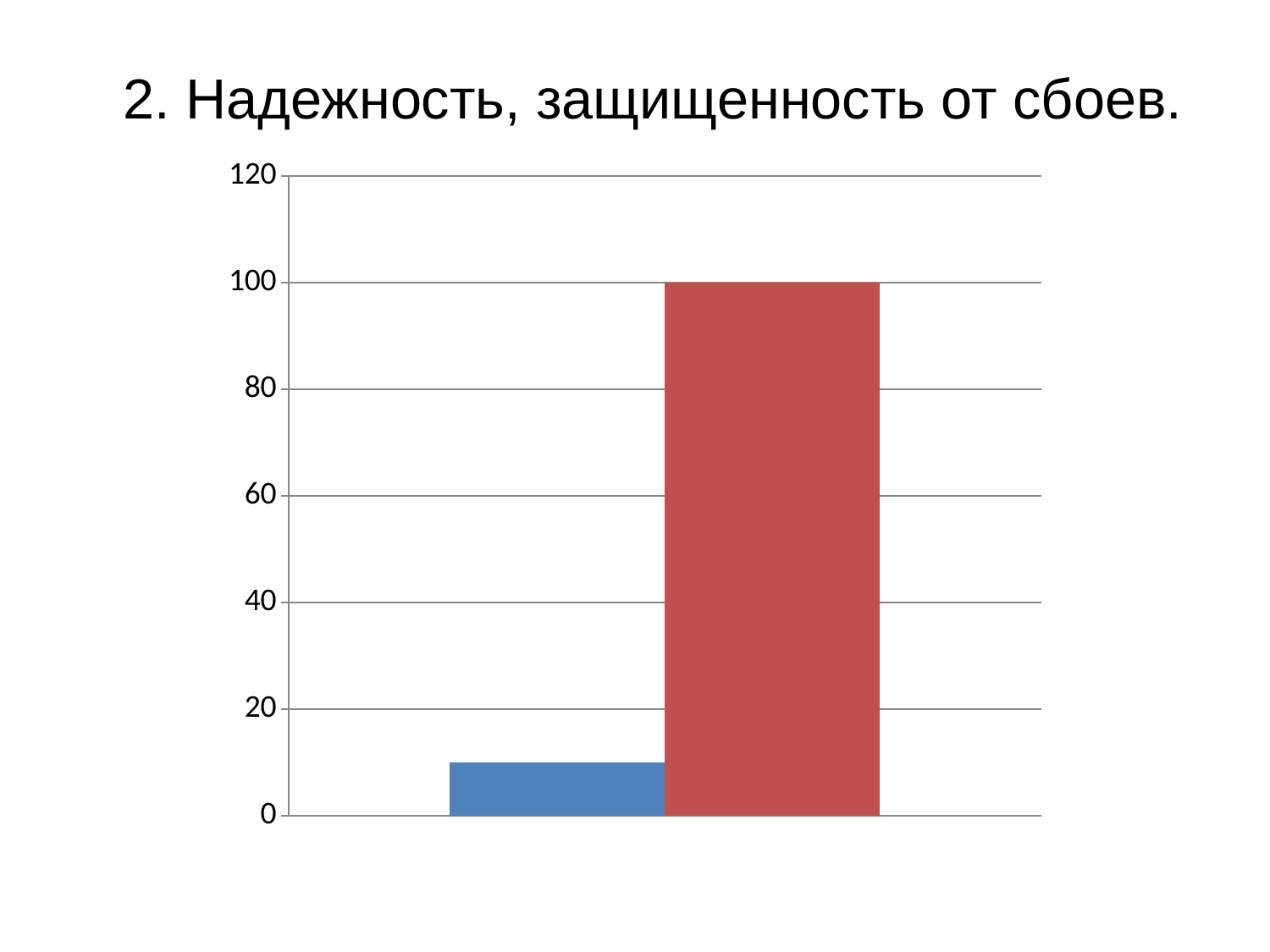
What is the highest value shown on the vertical axis? 120 Is the value of the red bar greater or less than 80? greater Which bar has the lowest value in the chart? the blue bar Which bar has the highest value in the chart? the red bar What value does the red bar reach on the vertical axis? 100 What kind of chart is shown on the slide? bar chart Is the value of the blue bar greater or less than 20? less What is the title of the slide containing the chart? 2. Надежность, защищенность от сбоев. Which bar is taller, the blue bar or the red bar? the red bar How many bars are plotted in the chart? 2